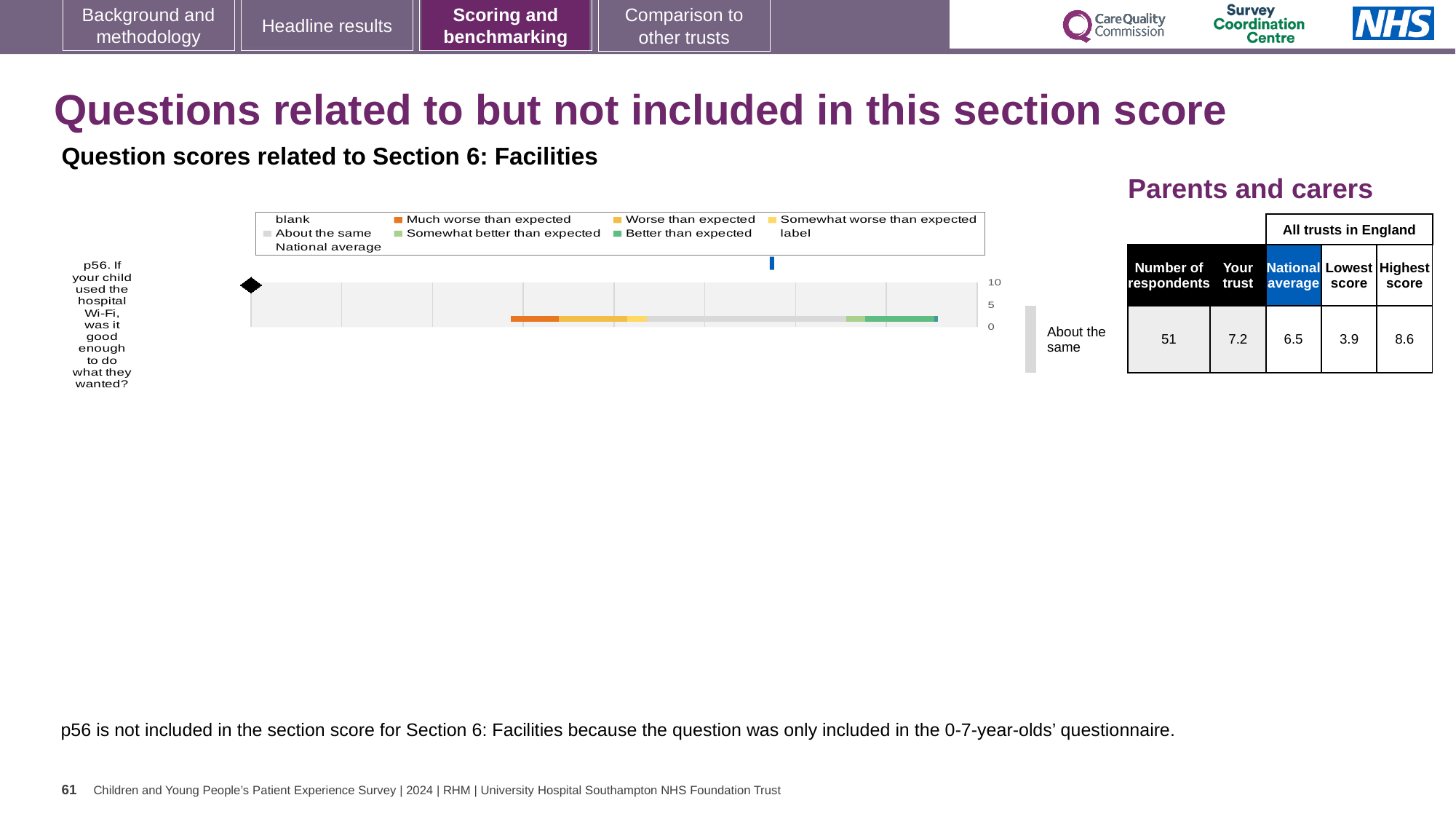
What is the highest score across all trusts in England for p56? 8.6 How many questions are plotted in the chart? 1 Which is larger for p56, the trust's score or the national average? Your trust Which question is plotted in the chart? p56. If your child used the hospital Wi-Fi, was it good enough to do what they wanted? What benchmark category is the trust's p56 score placed in? About the same What kind of chart is used to show the p56 question score? bar chart What is the difference between the trust's score and the national average for p56? 0.7 What is the national average score for p56? 6.5 What is the highest value shown on the chart's numeric axis? 10 How many respondents answered p56? 51 What is the lowest score across all trusts in England for p56? 3.9 What is the 'Your trust' score for p56 in the table? 7.2